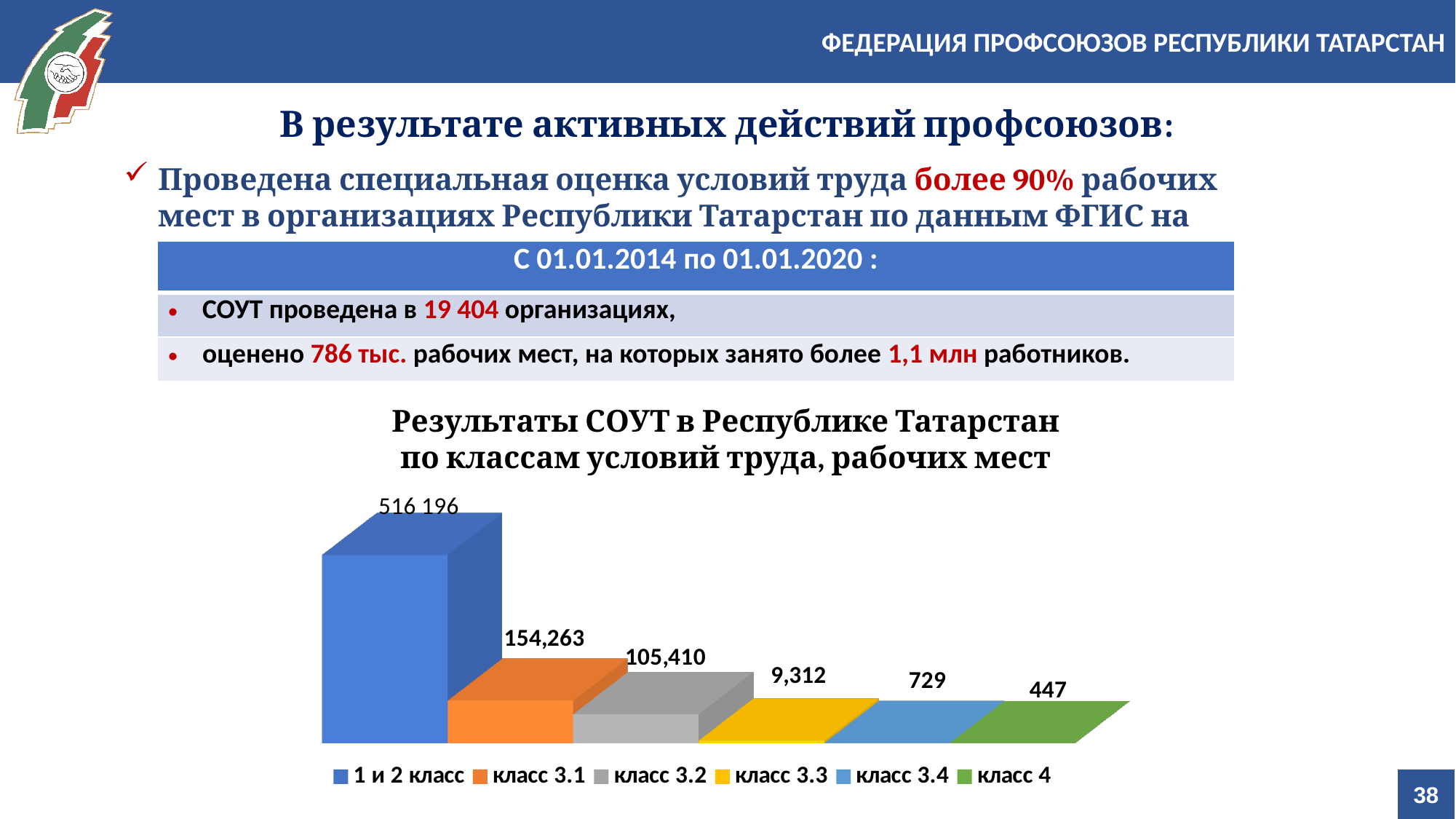
How many bars are plotted in the chart? 6 Which category has the highest value in the chart? 1 и 2 класс What value is shown for "класс 3.3" in the chart? 9,312 What is the difference between the values for "класс 3.1" and "класс 3.2"? 48,853 What value is shown for "класс 3.2" in the chart? 105,410 What is the difference between the values for "класс 3.4" and "класс 4"? 282 Which category has the lowest value in the chart? класс 4 What value is shown for "класс 4" in the chart? 447 What value is shown for "1 и 2 класс" in the chart? 516 196 What kind of chart is shown on the slide? Bar chart What value is shown for "класс 3.1" in the chart? 154,263 Which is larger: the value for "класс 3.3" or the value for "класс 3.4"? класс 3.3